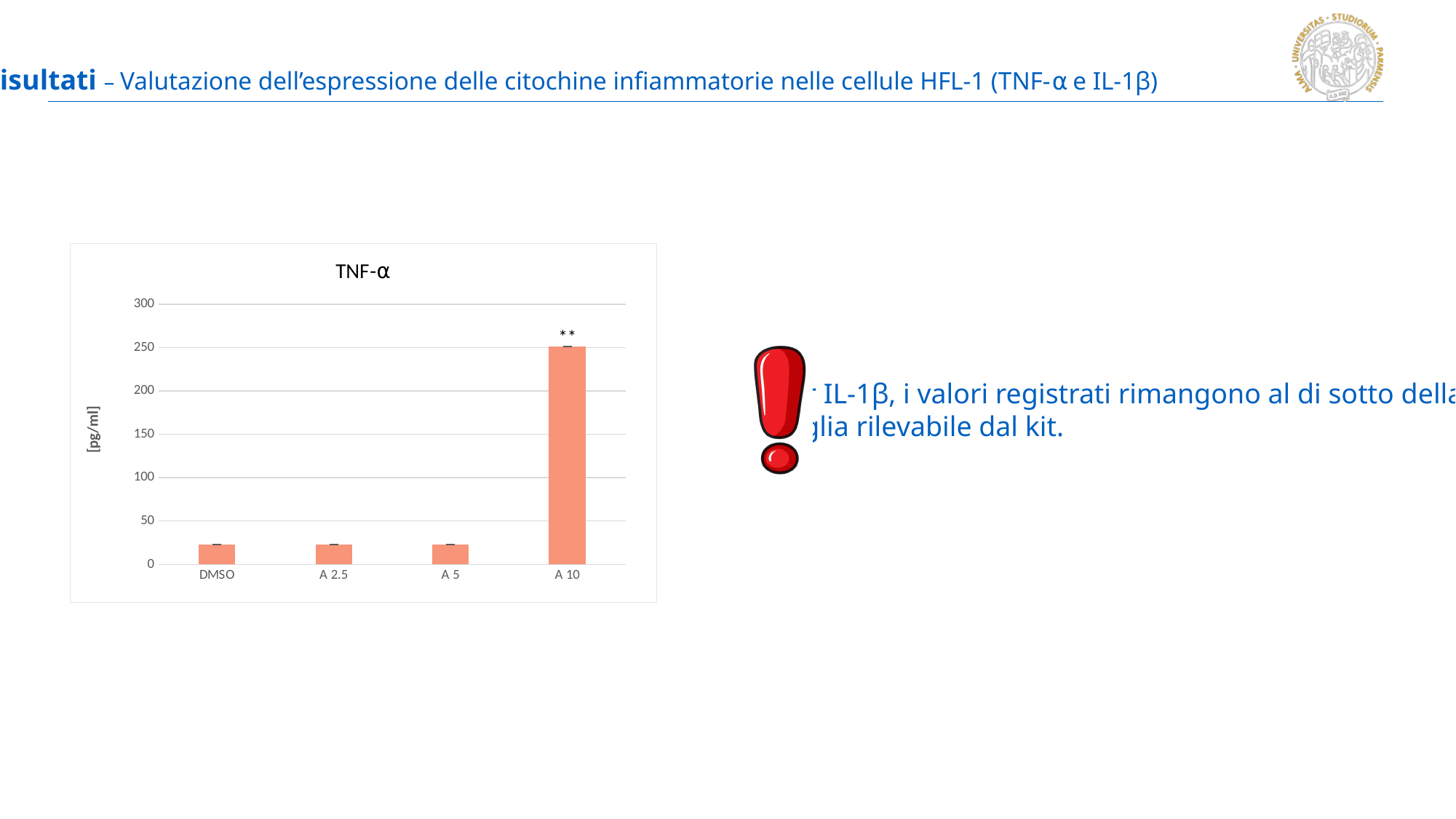
What is the highest tick value shown on the vertical axis of the chart? 300 Which is larger, the value for A 5 or the value for A 10? A 10 Which category has the highest value in the chart? A 10 What is the label on the vertical axis of the chart? [pg/ml] Is the value for A 2.5 greater or less than 50? less What kind of chart is shown on the slide? bar chart Is the value for A 10 greater or less than 200? greater Which is larger, the value for A 10 or the value for DMSO? A 10 How many categories are plotted on the x axis of the chart? 4 What is the title of the chart? TNF-α Is the value for A 5 greater or less than 100? less